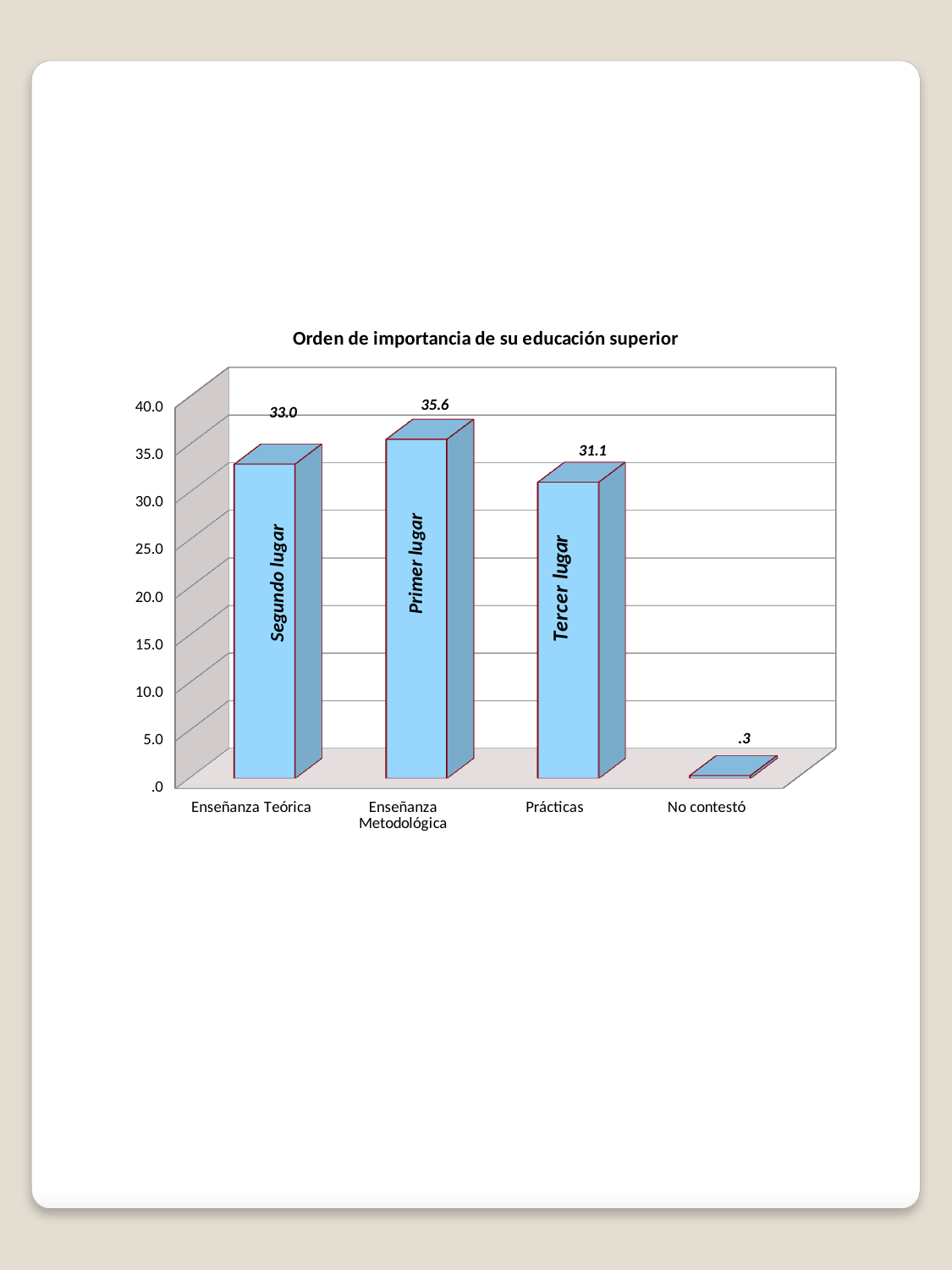
What is the value for No contestó? .3 What is the difference between the values for Enseñanza Metodológica and Prácticas? 4.5 Which category has the highest value? Enseñanza Metodológica What is the value for Enseñanza Metodológica? 35.6 What is the title of the chart? Orden de importancia de su educación superior Is the value for Prácticas greater or less than 30.0? greater What is the value for Enseñanza Teórica? 33.0 Which category has the lowest value? No contestó How many categories are shown on the x axis? 4 Which is larger, the value for Enseñanza Teórica or the value for Prácticas? Enseñanza Teórica What is the value for Prácticas? 31.1 What kind of chart is shown on the slide? Bar chart